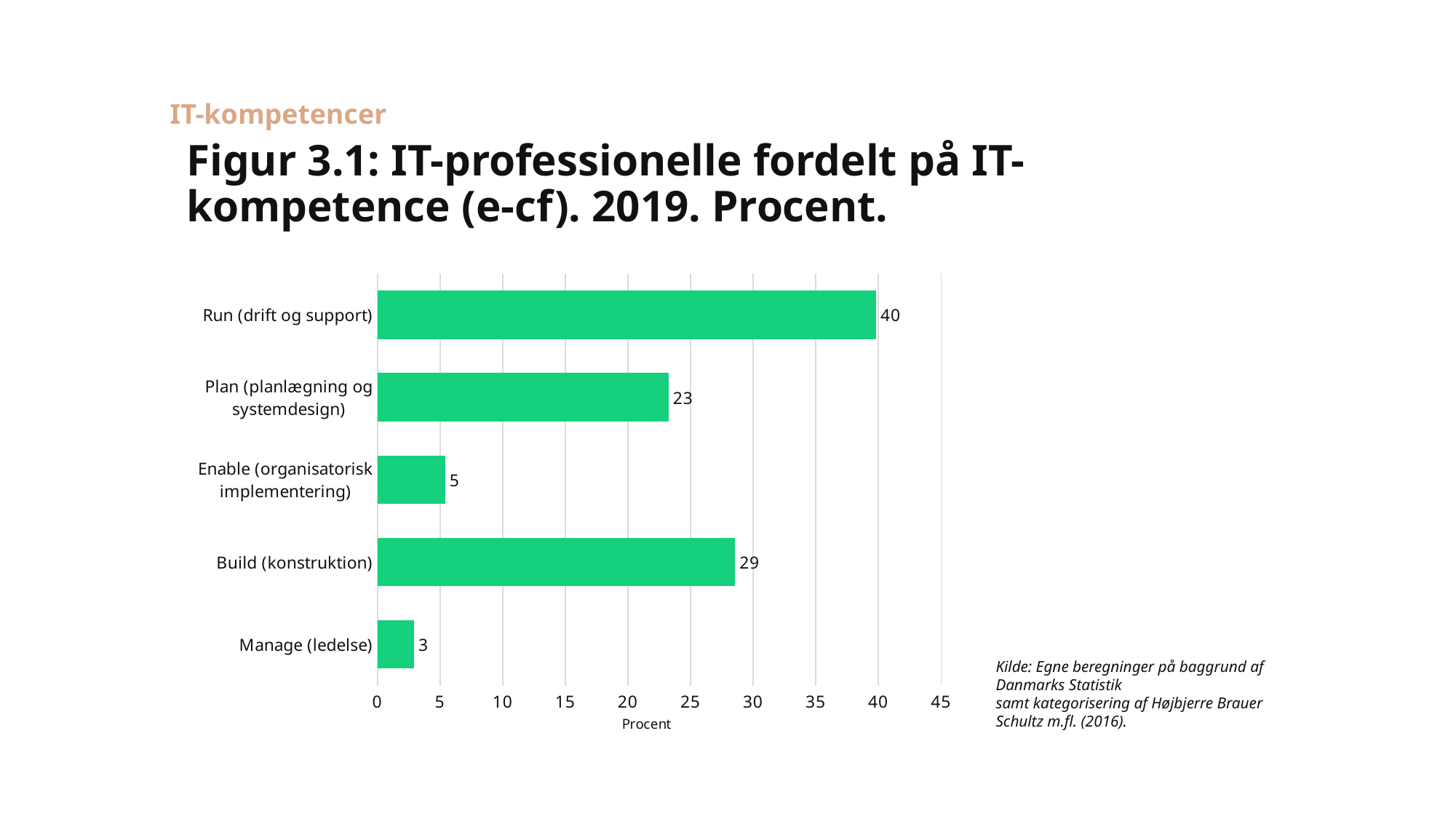
What is the value for Enable (organisatorisk implementering)? 5 What is the value for Manage (ledelse)? 3 Is the value for Build (konstruktion) greater or less than 25? greater What kind of chart is shown on the slide? Bar chart How many categories are shown in the chart? 5 Which is larger, the value for Plan (planlægning og systemdesign) or Build (konstruktion)? Build (konstruktion) What is the difference between the values for Run (drift og support) and Build (konstruktion)? 11 Which category has the lowest value? Manage (ledelse) What is the label on the horizontal axis? Procent Which category has the highest value? Run (drift og support) What is the value for Plan (planlægning og systemdesign)? 23 What is the value for Run (drift og support)? 40